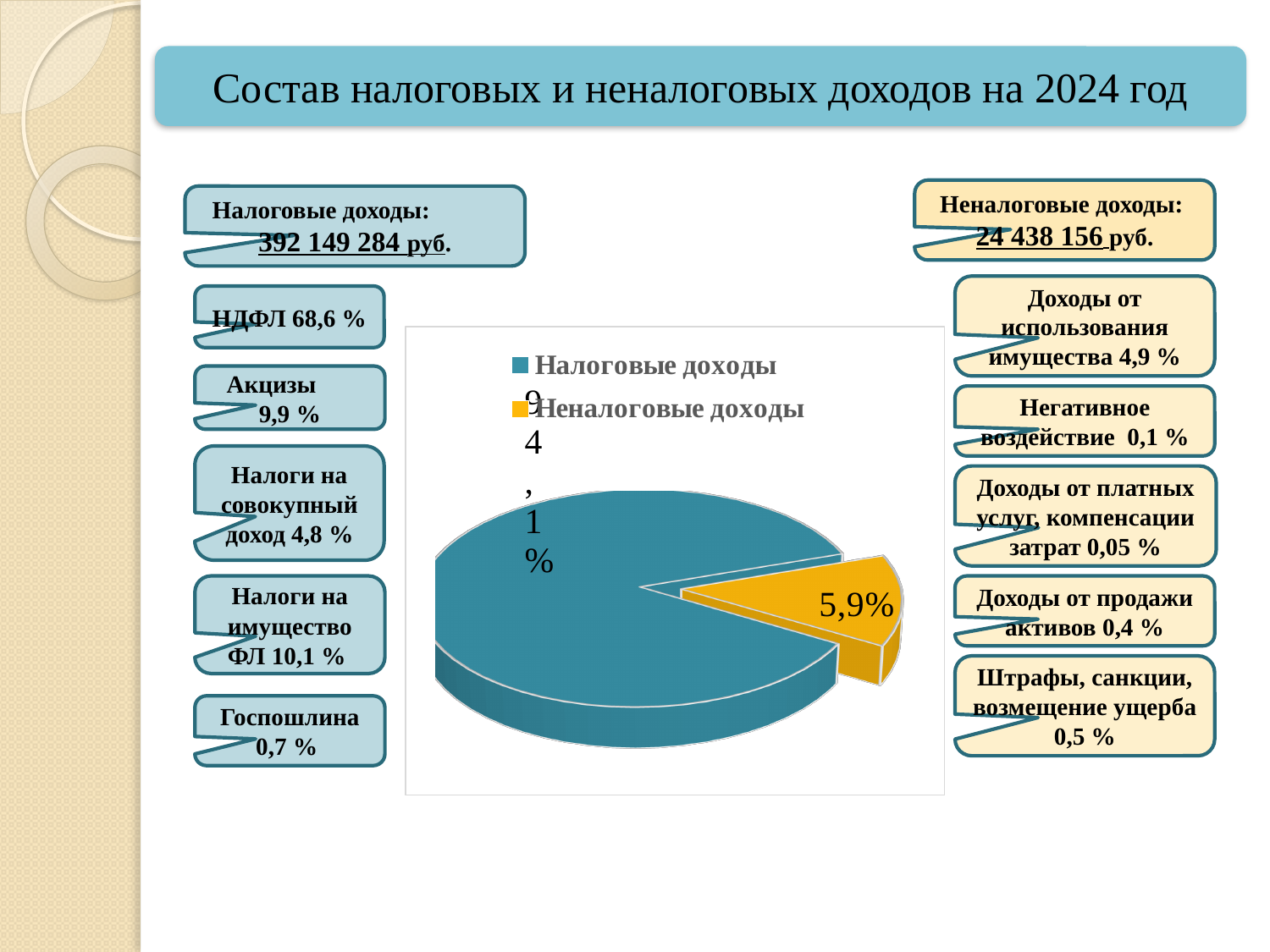
How many slices does the pie chart have? 2 What colour is the Неналоговые доходы slice in the pie chart? yellow What share of the pie does Налоговые доходы take? 94,1% What share of the pie does Неналоговые доходы take? 5,9% Which slice of the pie chart is the smallest? Неналоговые доходы How many entries does the chart legend list? 2 Which slice of the pie chart is the largest? Налоговые доходы What is the difference in percentage points between the Налоговые доходы and Неналоговые доходы slices? 88,2 What colour is the Налоговые доходы slice in the pie chart? teal What kind of chart is shown on the slide? pie chart Which is larger in the pie chart, Налоговые доходы or Неналоговые доходы? Налоговые доходы